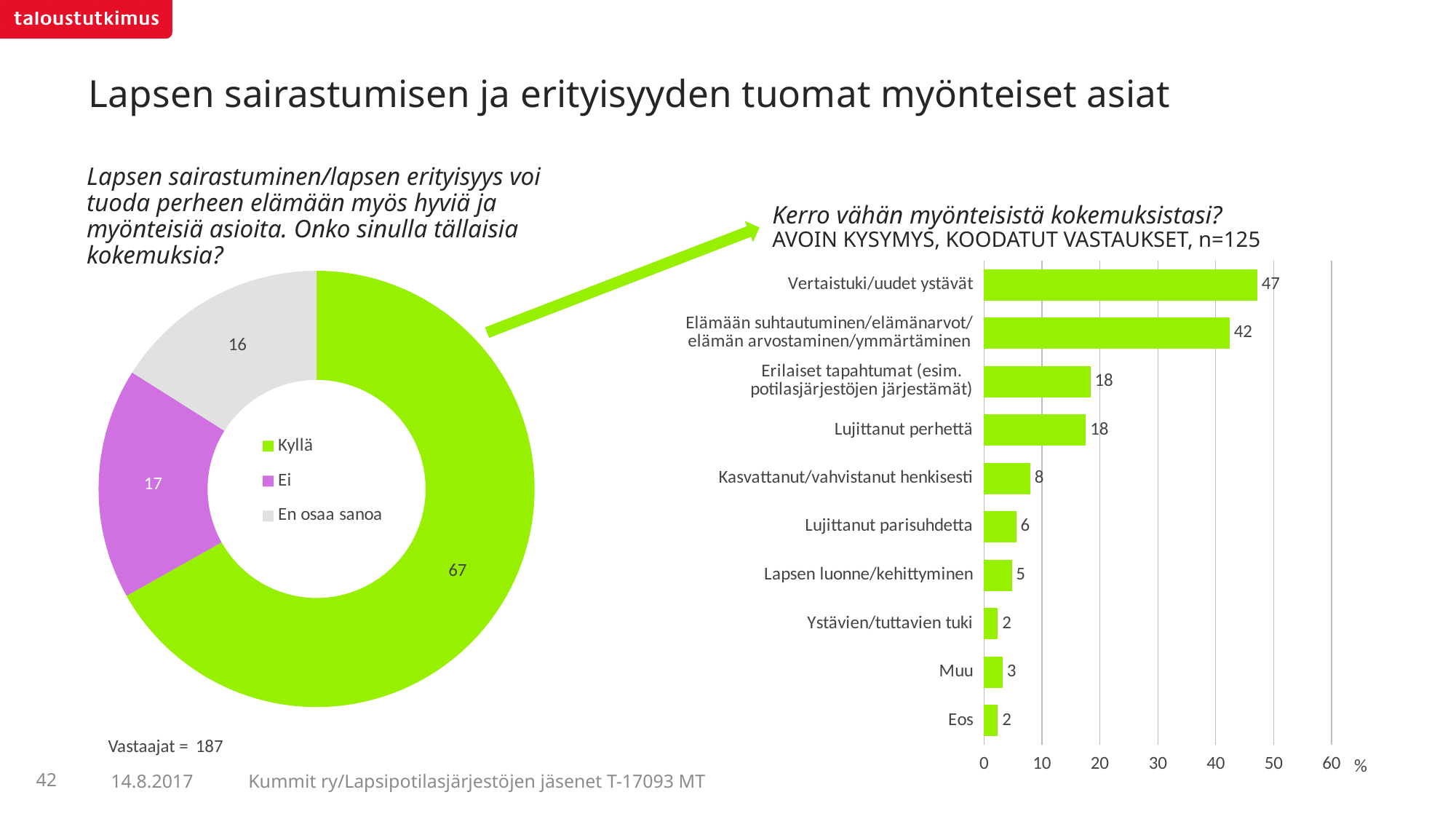
In the donut chart on the left, which category has the largest share? Kyllä In the bar chart on the right, what is the value for "Lujittanut parisuhdetta"? 6 In the bar chart on the right, what is the value for "Vertaistuki/uudet ystävät"? 47 In the bar chart on the right, what is the difference between "Vertaistuki/uudet ystävät" and "Elämään suhtautuminen/elämänarvot/elämän arvostaminen/ymmärtäminen"? 5 In the donut chart on the left, how many entries does the legend list? 3 What type of chart is shown on the right side of the slide? Bar chart In the donut chart on the left, what is the difference between the values for "Ei" and "En osaa sanoa"? 1 In the bar chart on the right, which is larger: "Kasvattanut/vahvistanut henkisesti" or "Lapsen luonne/kehittyminen"? Kasvattanut/vahvistanut henkisesti In the donut chart on the left, what is the value for "En osaa sanoa"? 16 In the bar chart on the right, how many categories are shown? 10 In the bar chart on the right, which category has the highest value? Vertaistuki/uudet ystävät In the donut chart on the left, what is the value for "Kyllä"? 67